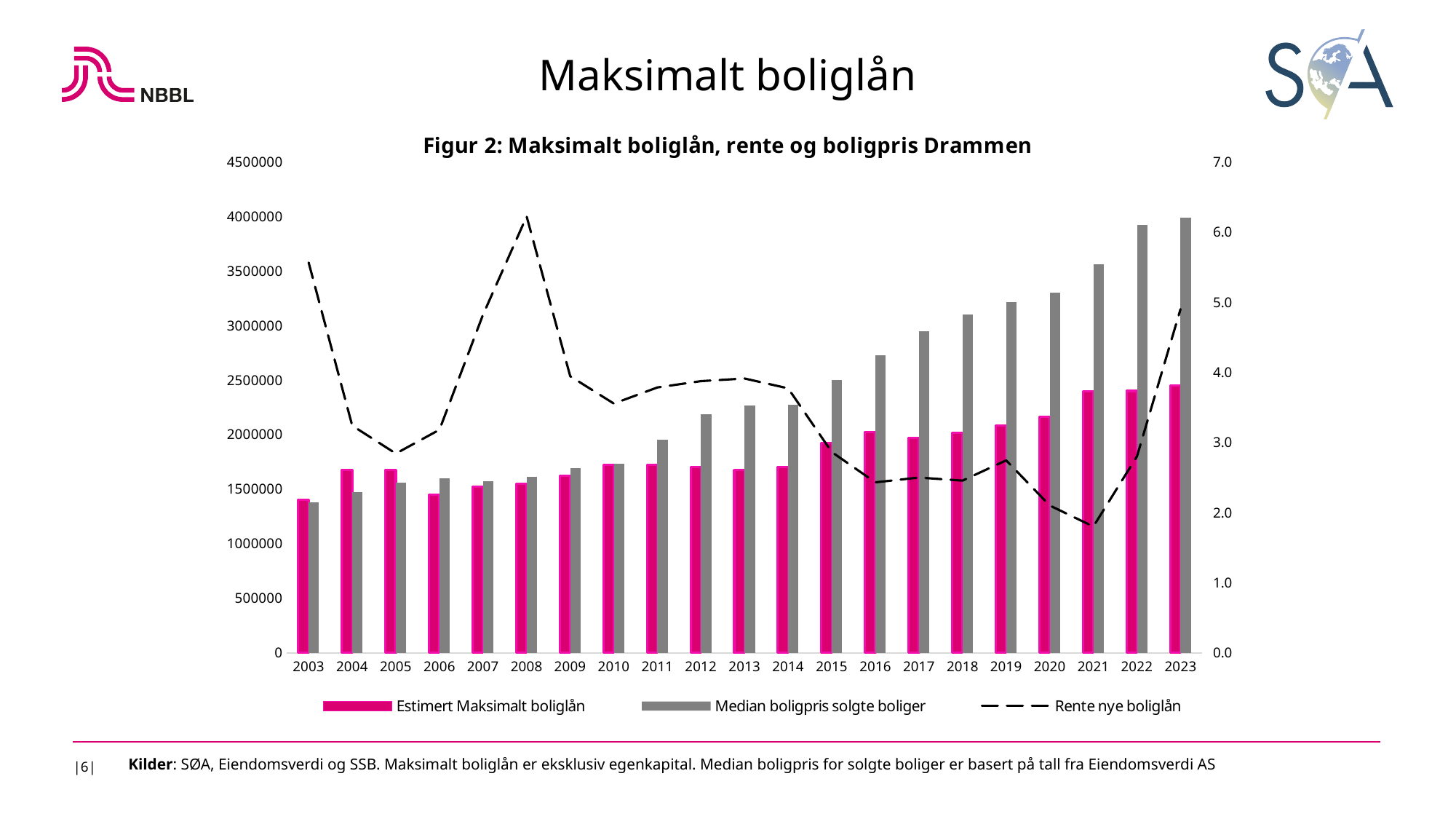
How many series does the legend of Figur 2 list? 3 What kind of chart is shown in Figur 2? A combined bar and line chart In which year is Median boligpris solgte boliger lowest? 2003 How many years are shown on the x axis of Figur 2? 21 In which year is Rente nye boliglån highest? 2008 Is the value for Rente nye boliglån in 2015 greater or less than 4.0? less Is the value for Estimert Maksimalt boliglån in 2023 greater or less than 2000000? greater In which year is Rente nye boliglån lowest? 2021 Does Median boligpris solgte boliger generally rise or fall from 2003 to 2023? Rise Is the value for Median boligpris solgte boliger in 2023 greater or less than 3500000? greater In which year is Median boligpris solgte boliger highest? 2023 In 2023, which is larger: Estimert Maksimalt boliglån or Median boligpris solgte boliger? Median boligpris solgte boliger